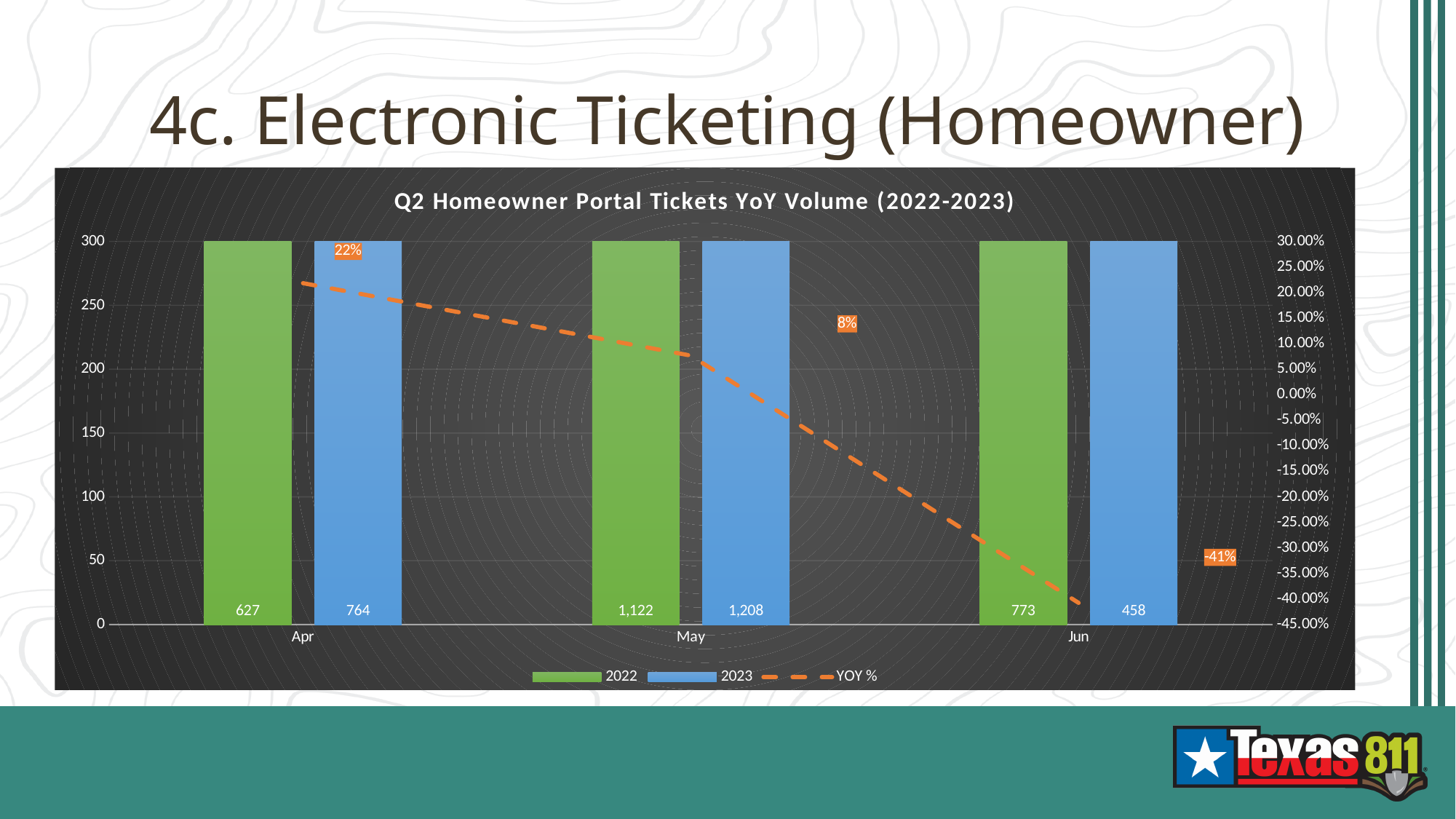
What is the value for 2023 in May? 1,208 How many series does the legend list? 3 What is the value for 2022 in Apr? 627 What is the YOY % value shown for Jun? -41% Which month has the highest 2023 value? May Does the YOY % line rise or fall from Apr to Jun? fall What is the difference between the 2023 and 2022 values in May? 86 Which month has the lowest 2023 value? Jun Which is larger in Jun, the 2022 value or the 2023 value? 2022 What is the YOY % value shown for Apr? 22% What is the value for 2023 in Jun? 458 How many months are shown on the x axis? 3